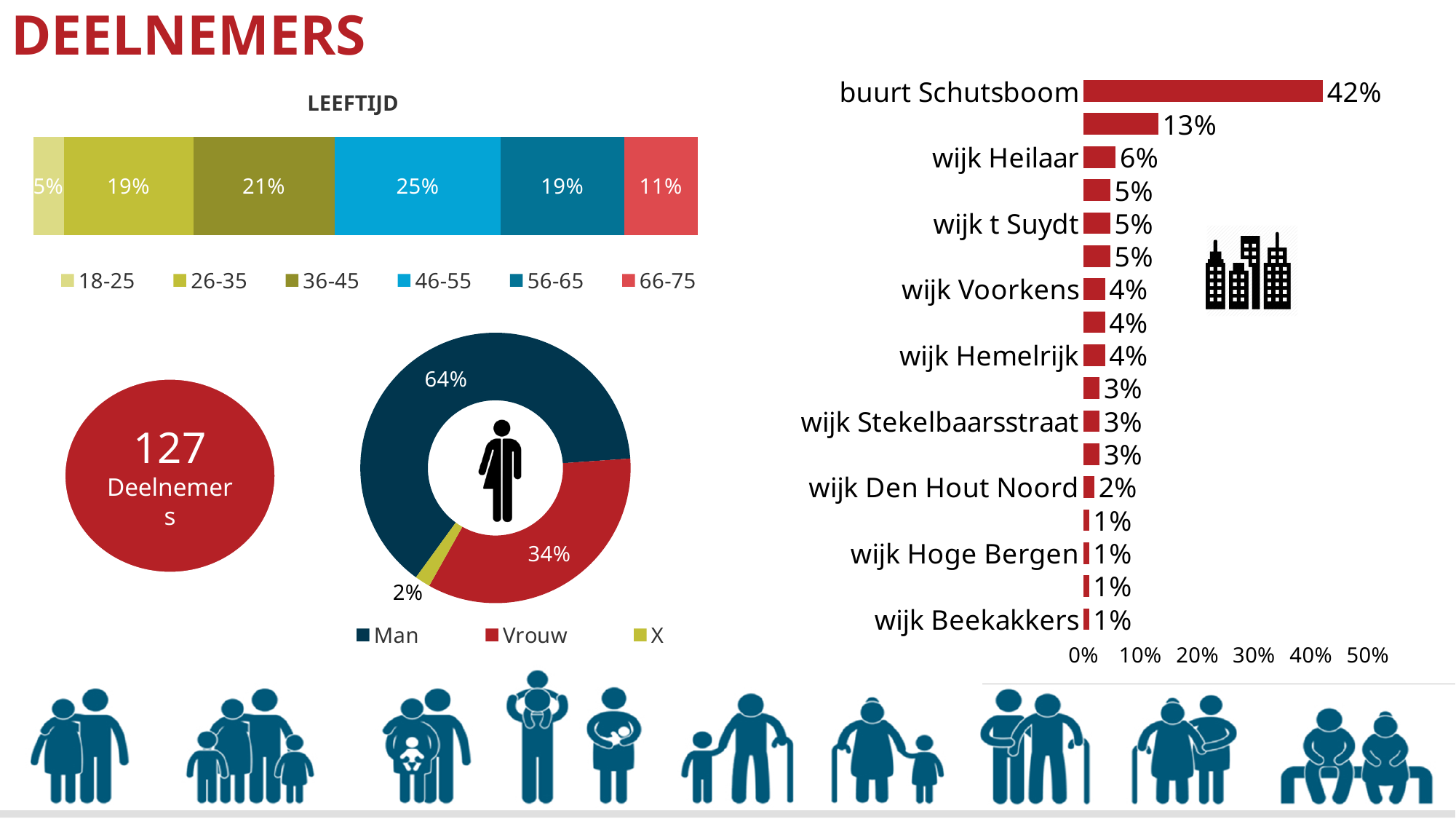
What kind of chart is the neighbourhood chart on the right side of the slide? Bar chart In the neighbourhood bar chart on the right, which labelled neighbourhood has the highest value? buurt Schutsboom In the LEEFTIJD chart, what is the difference between the 36-45 and 66-75 shares? 10% In the donut chart, what is the difference between the Man and Vrouw shares? 30% In the LEEFTIJD chart, what percentage is shown for the 46-55 age group? 25% In the LEEFTIJD chart, how many age groups does the legend list? 6 In the donut chart, which category has the largest share? Man In the LEEFTIJD chart, which age group has the largest share? 46-55 In the neighbourhood bar chart on the right, what is the value for buurt Schutsboom? 42% In the donut chart, what share is labelled for Vrouw? 34% In the LEEFTIJD chart, which age group has the smallest share? 18-25 In the neighbourhood bar chart on the right, is the value for wijk Heilaar greater or less than 10%? less